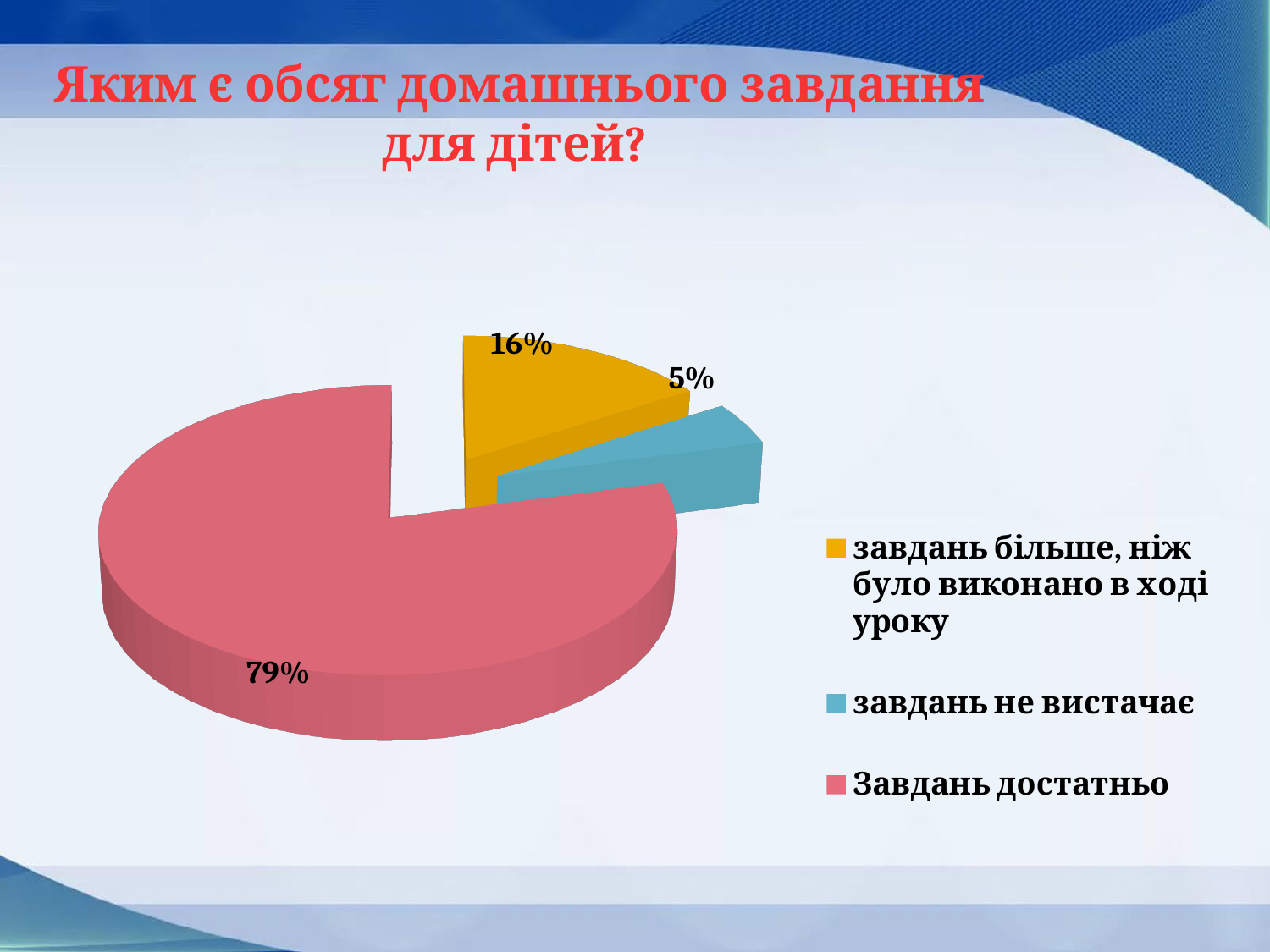
What is the title of the slide above the chart? Яким є обсяг домашнього завдання для дітей? What percentage of the pie is labelled "завдань більше, ніж було виконано в ході уроку"? 16% What kind of chart is shown on the slide? Pie chart Which category has the smallest share of the pie? завдань не вистачає How many slices does the pie chart have? 3 What is the difference in percentage points between "завдань більше, ніж було виконано в ході уроку" and "завдань не вистачає"? 11 Which category has the largest share of the pie? Завдань достатньо Which is larger: the share for "завдань не вистачає" or the share for "завдань більше, ніж було виконано в ході уроку"? завдань більше, ніж було виконано в ході уроку What is the difference in percentage points between "Завдань достатньо" and "завдань більше, ніж було виконано в ході уроку"? 63 What colour is the slice for "Завдань достатньо"? Red (pink) What percentage of the pie is labelled "завдань не вистачає"? 5% What percentage of the pie is labelled "Завдань достатньо"? 79%